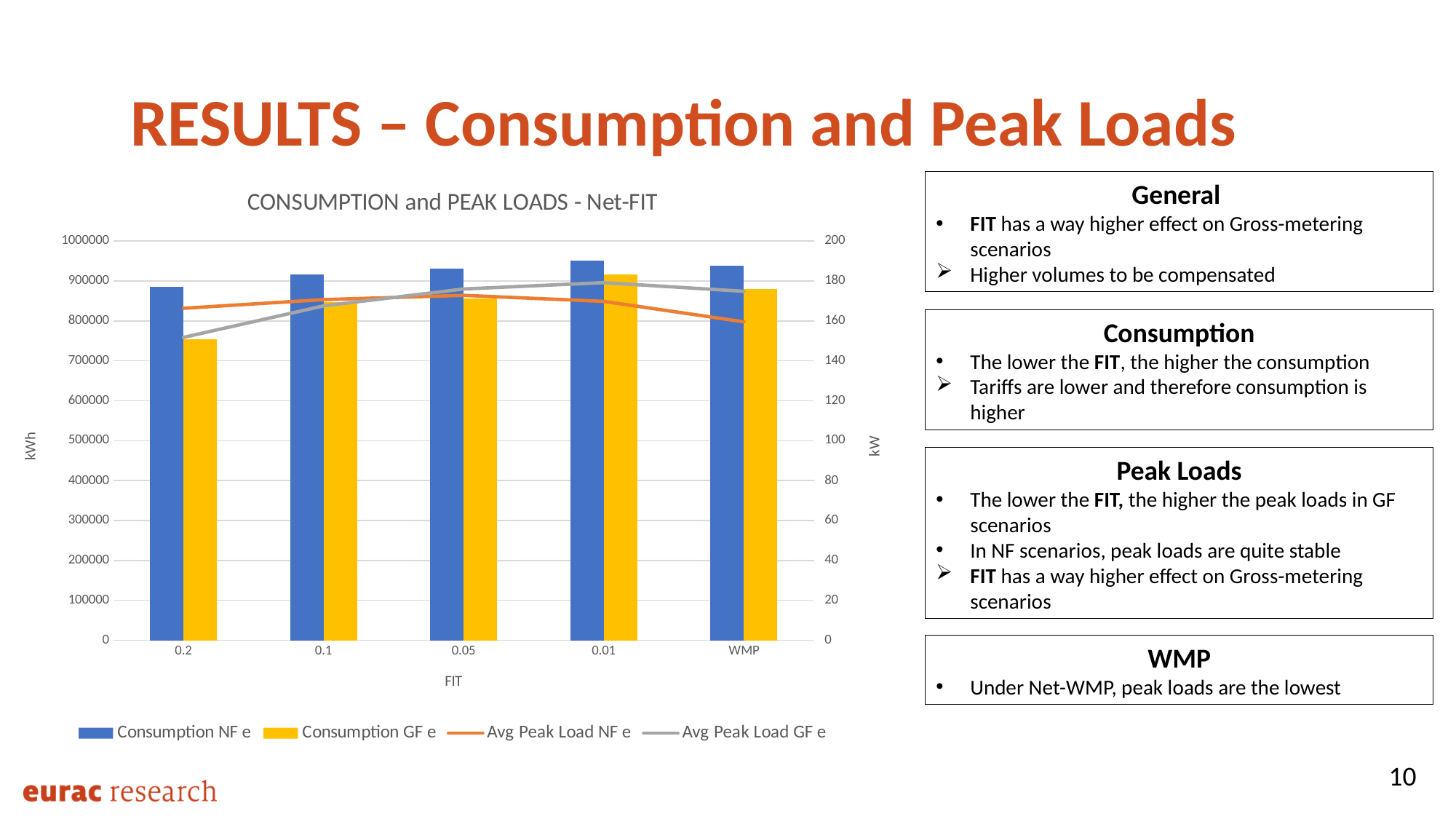
For which FIT category is Consumption GF e lowest? 0.2 Does Consumption GF e rise or fall as FIT goes from 0.2 to 0.01? rise Is the Consumption GF e value at FIT 0.2 greater or less than 800000? less How many FIT categories are shown on the x axis? 5 At FIT 0.2, which is larger: Consumption NF e or Consumption GF e? Consumption NF e What kind of chart is used to plot the Consumption NF e and Consumption GF e series? bar chart What is the title of the chart? CONSUMPTION and PEAK LOADS - Net-FIT For which FIT category is Consumption GF e highest? 0.01 Is the Avg Peak Load GF e value at FIT 0.2 greater or less than 160? less How many series does the chart legend list? 4 For which FIT category is Consumption NF e lowest? 0.2 Is the Consumption NF e value at FIT 0.01 greater or less than 900000? greater